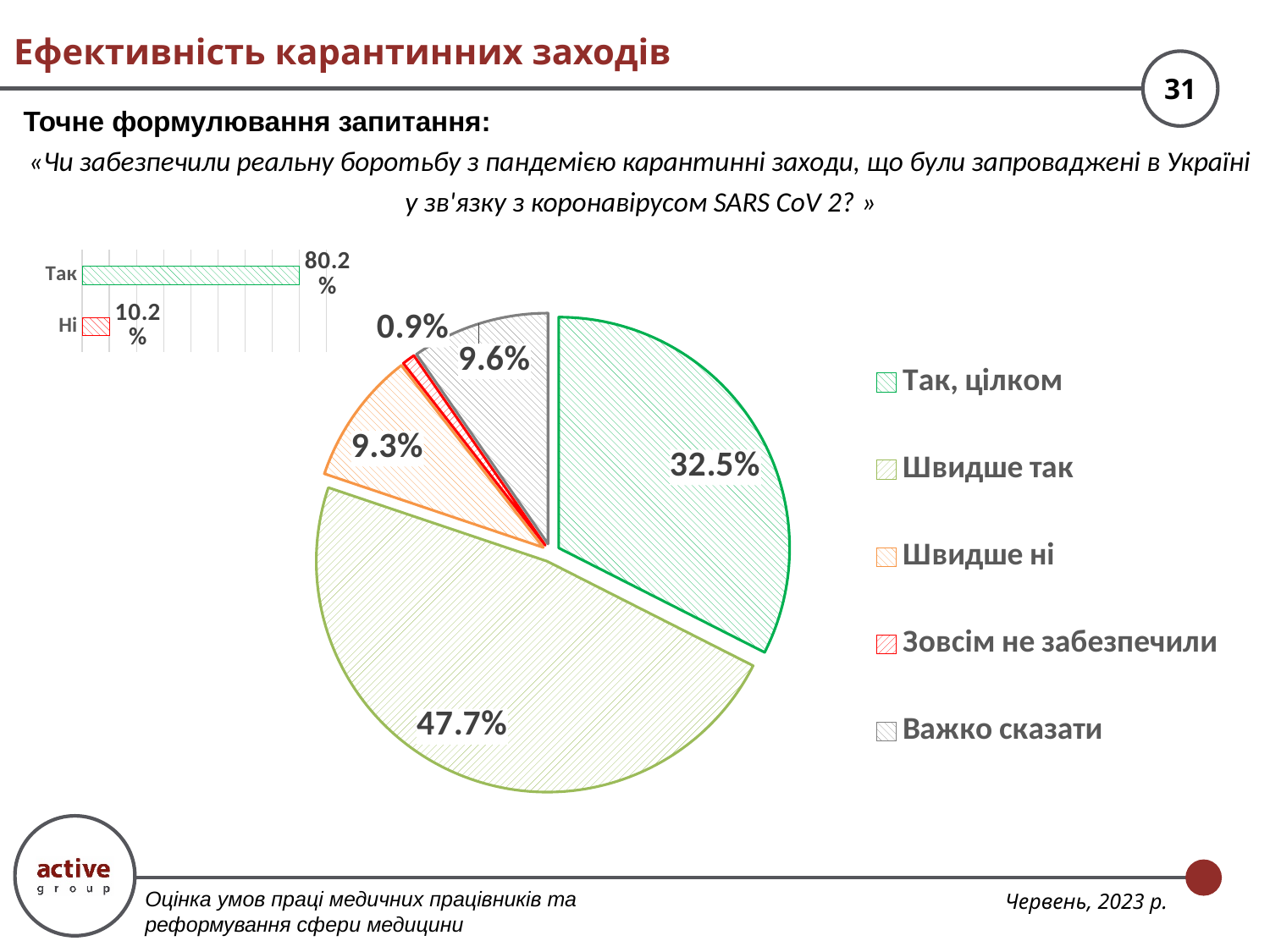
In the pie chart, which category has the smallest share? Зовсім не забезпечили In the pie chart, what percentage is shown for "Швидше так"? 47.7% In the small bar chart at the top left, what value is shown for "Ні"? 10.2% How many categories does the pie chart's legend list? 5 In the small bar chart at the top left, what value is shown for "Так"? 80.2% In the pie chart, what is the difference between the shares of "Швидше так" and "Так, цілком"? 15.2% In the pie chart, what percentage is shown for "Зовсім не забезпечили"? 0.9% In the pie chart, which is larger: "Важко сказати" or "Швидше ні"? Важко сказати In the pie chart, what percentage is shown for "Так, цілком"? 32.5% What type of chart is the small chart at the top left of the slide? Bar chart In the small bar chart at the top left, what is the difference between the values for "Так" and "Ні"? 70.0% In the pie chart, which category has the largest share? Швидше так